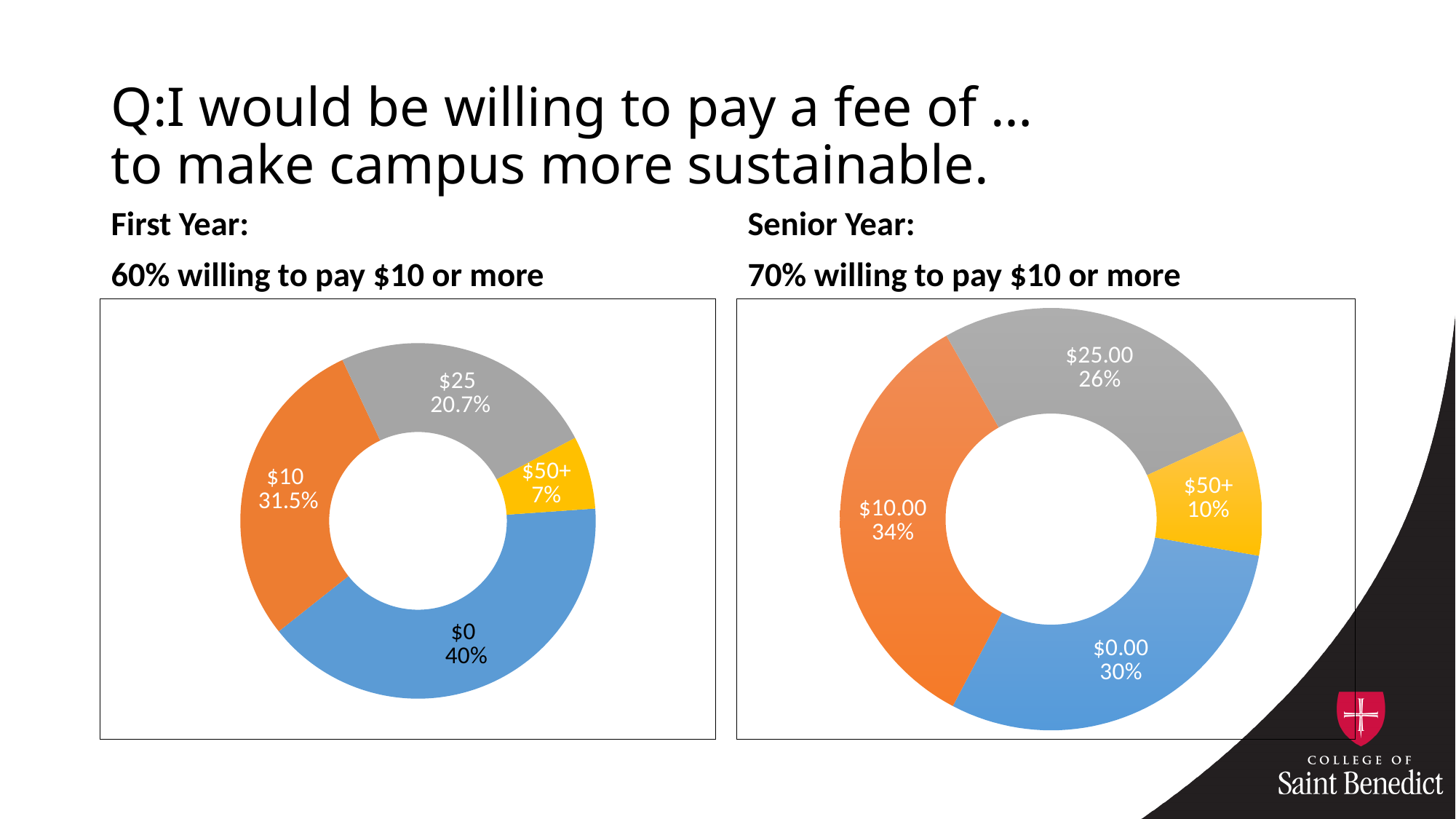
How many fee options are shown in the Senior Year chart on the right? 4 In the First Year chart on the left, what is the difference in percentage points between the $0 share and the $25 share? 19.3 In the First Year chart on the left, what percentage of respondents chose $0? 40% In the First Year chart on the left, what percentage of respondents chose $10? 31.5% In the First Year chart on the left, which fee option has the largest share? $0 Which is larger in the First Year chart on the left: the share for $25 or the share for $50+? $25 In the Senior Year chart on the right, what is the difference in percentage points between the $10.00 share and the $0.00 share? 4 In the Senior Year chart on the right, which fee option has the largest share? $10.00 In the Senior Year chart on the right, what percentage of respondents chose $50+? 10% In the Senior Year chart on the right, which fee option has the smallest share? $50+ What type of chart is the First Year chart on the left? Doughnut chart In the Senior Year chart on the right, what percentage of respondents chose $25.00? 26%